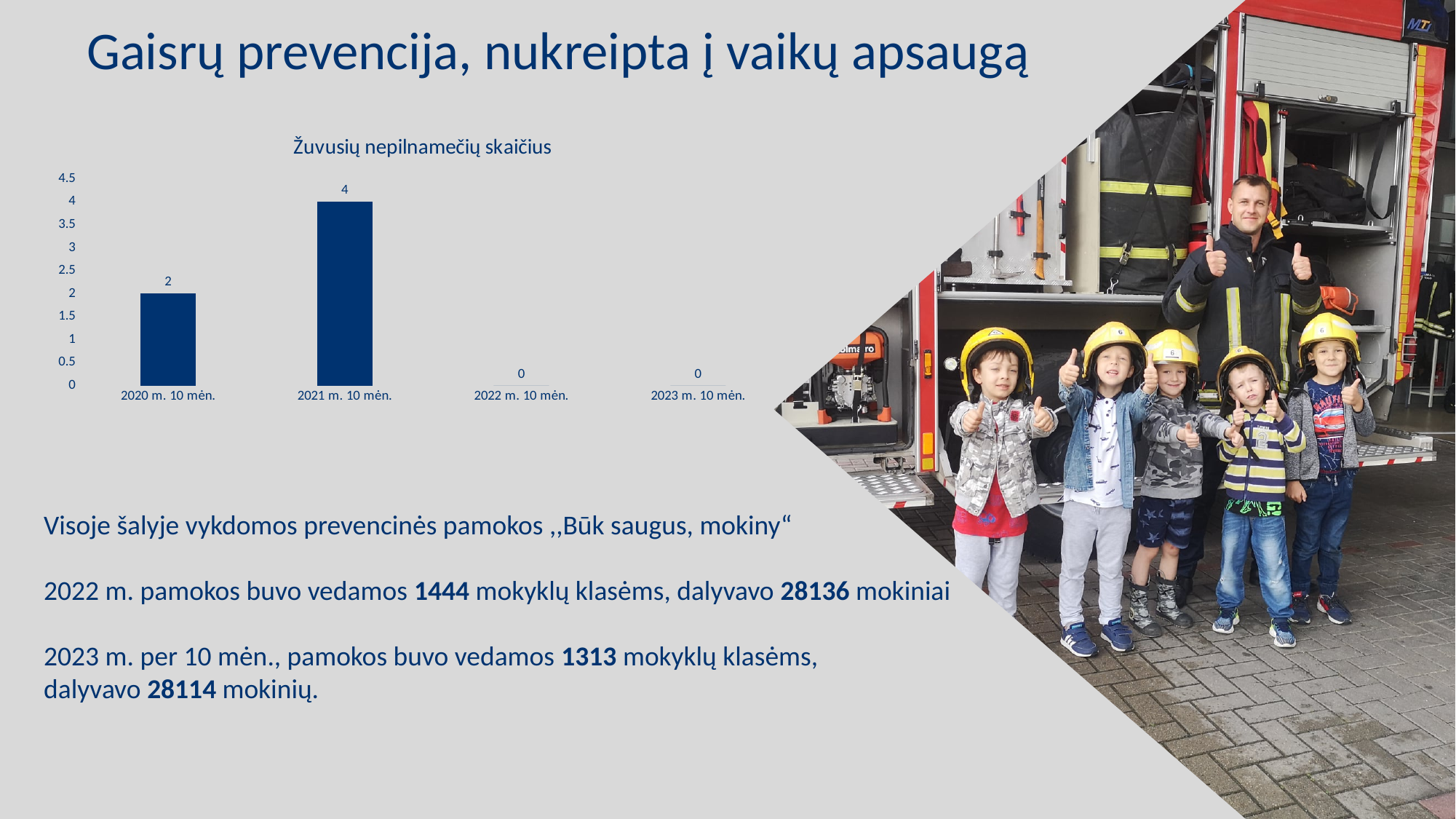
What kind of chart is shown? bar chart Do the values rise or fall from 2021 m. 10 mėn. to 2022 m. 10 mėn.? fall Which category has the highest value? 2021 m. 10 mėn. What is the difference between the values for 2021 m. 10 mėn. and 2020 m. 10 mėn.? 2 What is the value for 2021 m. 10 mėn.? 4 What is the title of the chart? Žuvusių nepilnamečių skaičius How many categories are shown on the x axis? 4 What is the value for 2023 m. 10 mėn.? 0 What is the value for 2020 m. 10 mėn.? 2 Which is larger, the value for 2020 m. 10 mėn. or 2021 m. 10 mėn.? 2021 m. 10 mėn. Is the value for 2021 m. 10 mėn. greater or less than 3? greater What is the value for 2022 m. 10 mėn.? 0